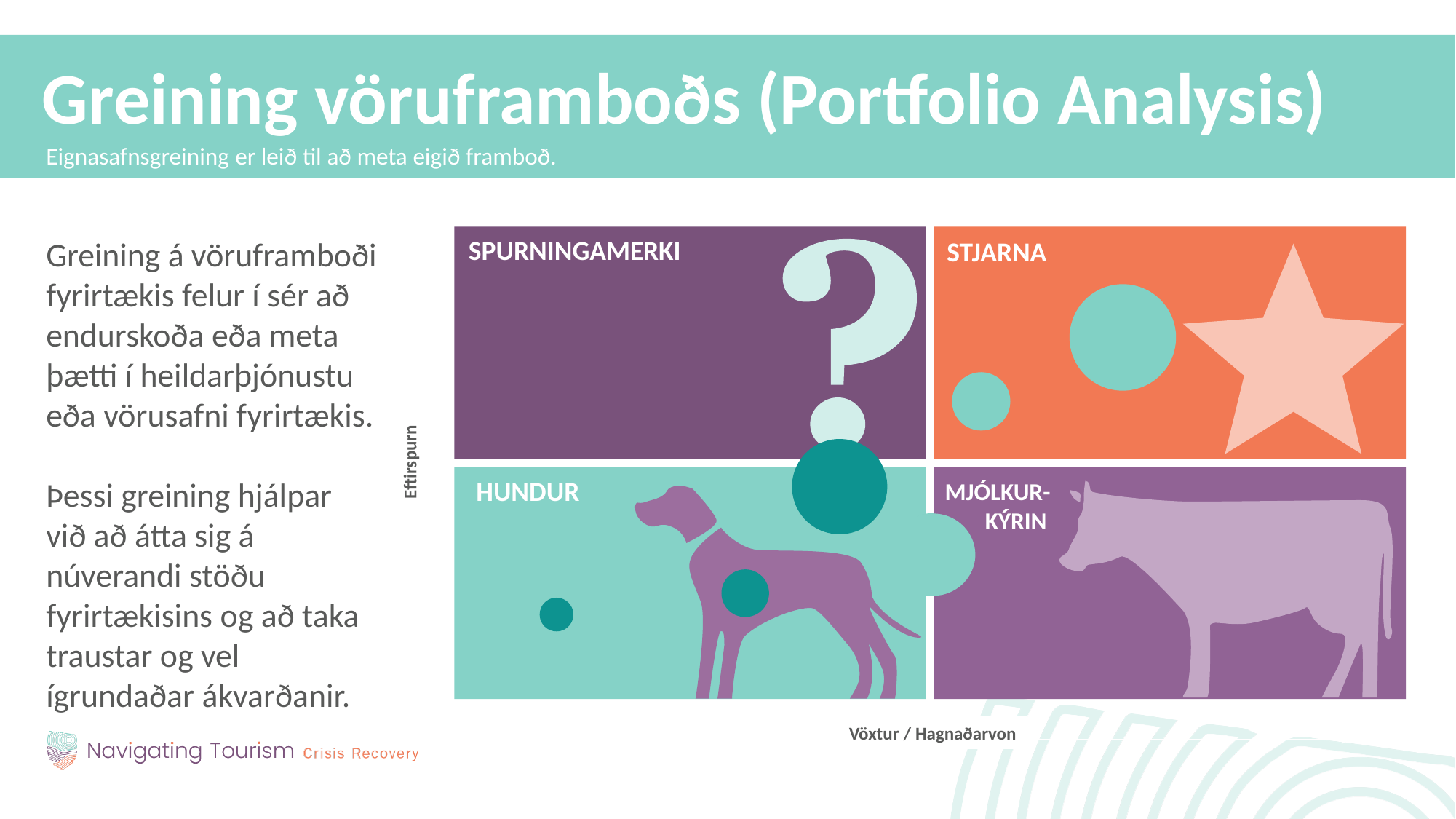
What is the label of the vertical axis of the matrix? Eftirspurn What kind of chart is shown on the slide? A bubble chart laid over a 2x2 quadrant matrix Which quadrant is in the top-right position of the matrix? STJARNA Which quadrant is in the top-left position of the matrix? SPURNINGAMERKI What is the label of the horizontal axis of the matrix? Vöxtur / Hagnaðarvon Which quadrant is in the bottom-right position of the matrix? MJÓLKURKÝRIN Which quadrant is in the bottom-left position of the matrix? HUNDUR How many quadrants does the portfolio analysis matrix on the slide have? 4